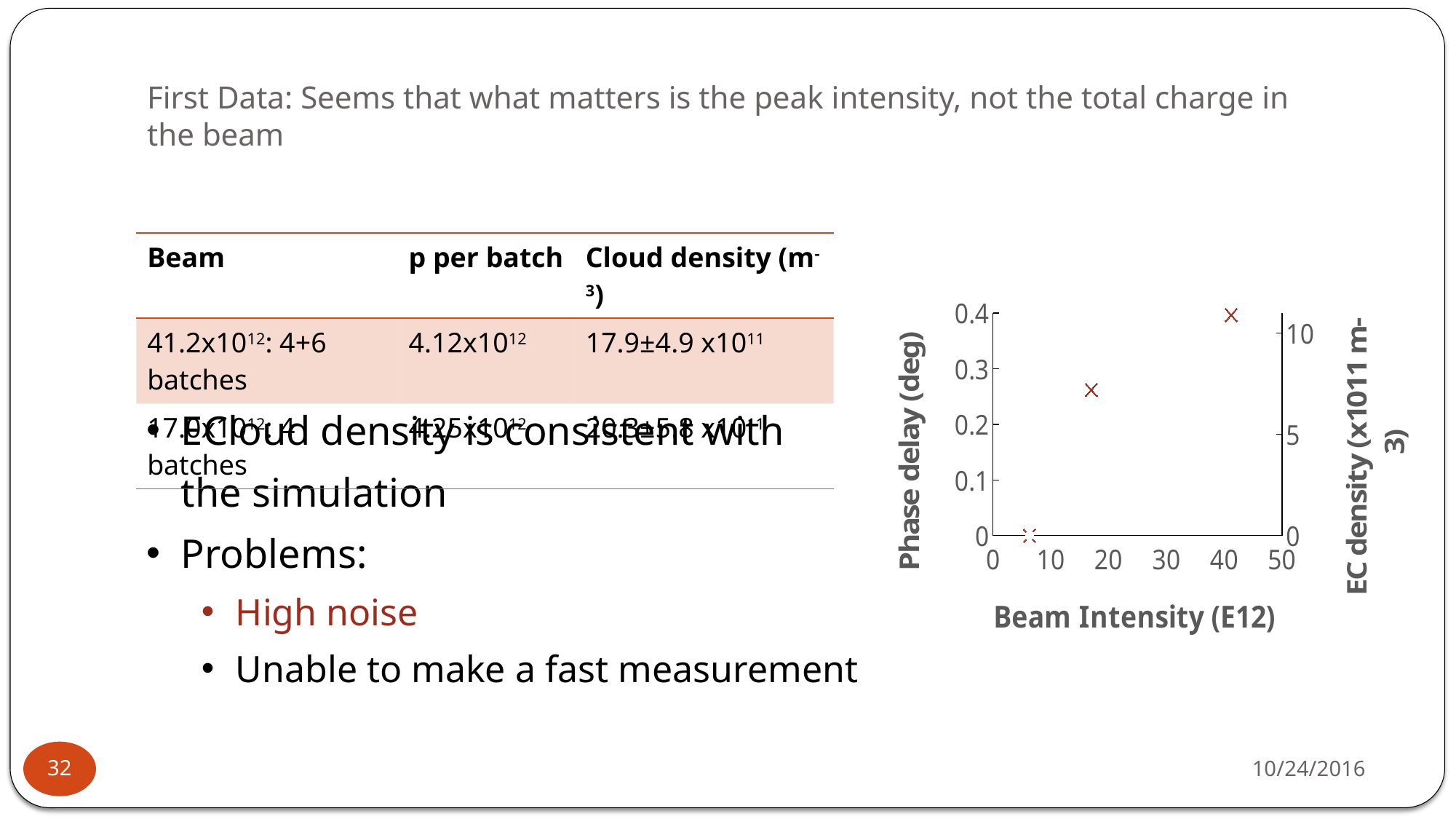
Which plotted point has the highest phase delay? The point at about 41 E12 beam intensity Is the phase delay for the point at a beam intensity of about 17 E12 greater or less than 0.3 deg? less What is the maximum value shown on the x axis of the chart? 50 What is the title of the left y axis of the chart? Phase delay (deg) What is the title of the x axis of the chart? Beam Intensity (E12) Is the phase delay for the point at a beam intensity of about 41 E12 greater or less than 0.3 deg? greater Is the phase delay for the point at a beam intensity of about 17 E12 greater or less than 0.2 deg? greater Which point has the higher phase delay: the one at about 17 E12 or the one at about 41 E12 beam intensity? The one at about 41 E12 Does the phase delay rise or fall as beam intensity increases along the x axis? Rises What kind of chart is shown on the right of the slide? Scatter chart